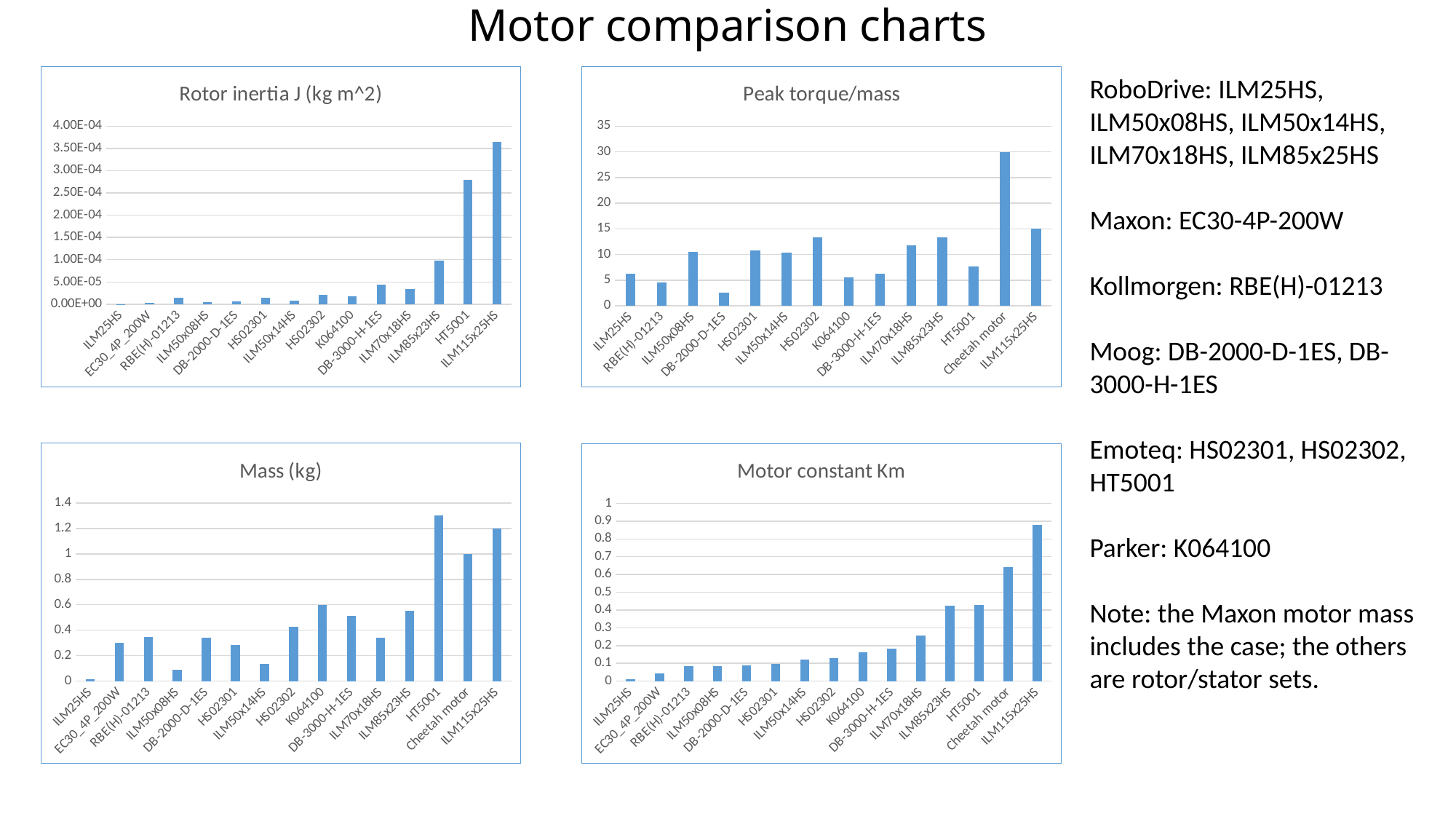
How many motors are plotted in the Rotor inertia J (kg m^2) chart? 14 What kind of chart is the Rotor inertia J (kg m^2) chart? bar chart In the Mass (kg) chart, which has the larger mass, K064100 or ILM50x14HS? K064100 In the Rotor inertia J (kg m^2) chart, which motor has the highest rotor inertia? ILM115x25HS In the Peak torque/mass chart, which motor has the highest value? Cheetah motor In the Motor constant Km chart, do the values generally rise or fall from left to right along the x axis? rise In the Mass (kg) chart, is the value for HT5001 greater or less than 1.2? greater In the Peak torque/mass chart, which motor has the lowest value? DB-2000-D-1ES In the Peak torque/mass chart, is the value for Cheetah motor greater or less than 25? greater How many motors are plotted in the Mass (kg) chart? 15 In the Motor constant Km chart, which motor has the highest value? ILM115x25HS